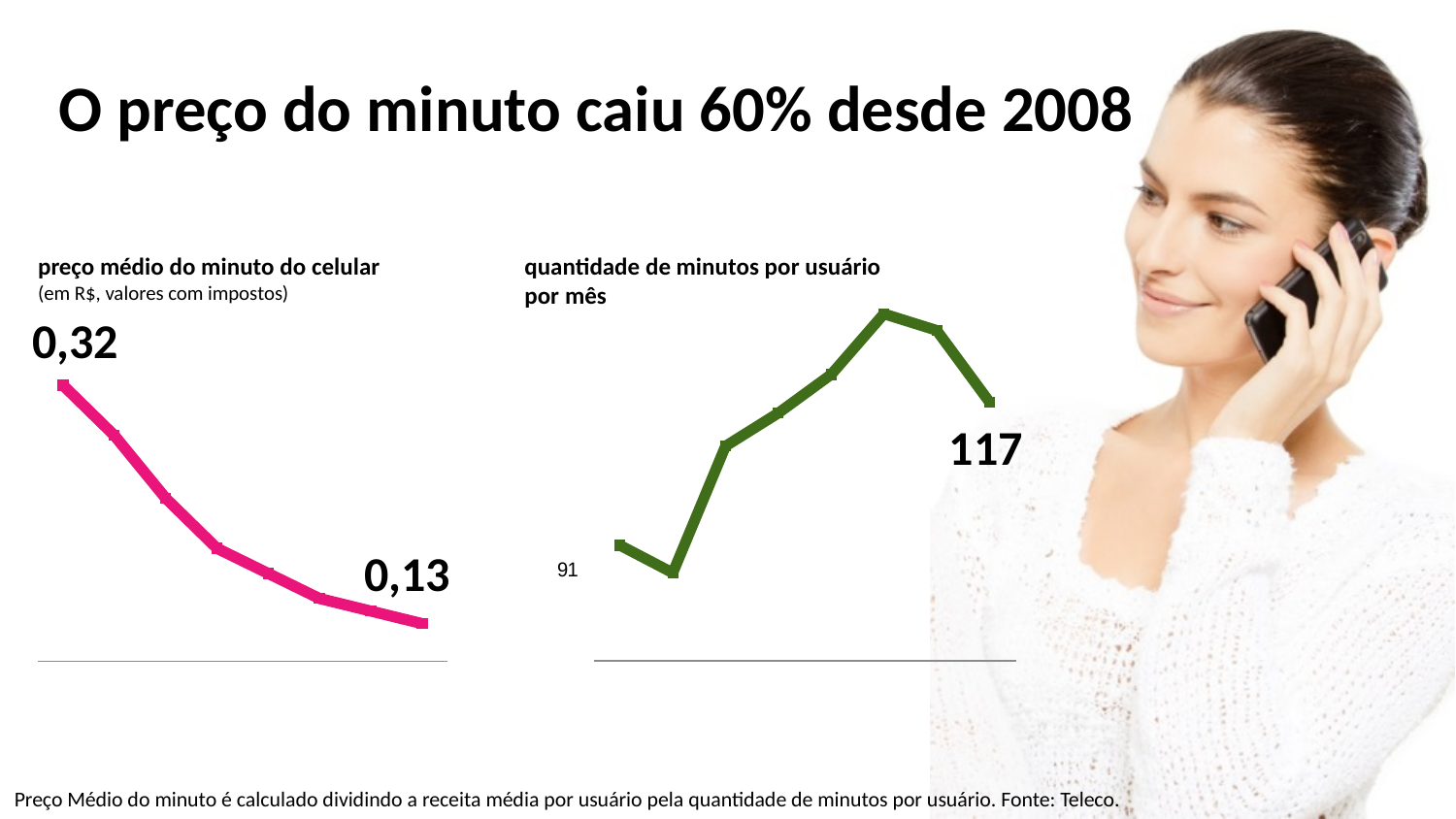
What kind of chart is the right chart, 'quantidade de minutos por usuário por mês'? line chart In the left chart 'preço médio do minuto do celular', is the first value (0,32) larger or smaller than the last value (0,13)? larger In the left chart 'preço médio do minuto do celular', do the values rise or fall along the x axis? fall In the right chart 'quantidade de minutos por usuário por mês', is the last value (117) larger or smaller than the first value (91)? larger In the left chart 'preço médio do minuto do celular', what is the value of the last point? 0,13 In the right chart 'quantidade de minutos por usuário por mês', what is the value of the first point? 91 In the left chart 'preço médio do minuto do celular', what is the value of the first point? 0,32 What kind of chart is the left chart, 'preço médio do minuto do celular'? line chart In the right chart 'quantidade de minutos por usuário por mês', what is the value of the last point? 117 In the left chart 'preço médio do minuto do celular', what is the difference between the first value (0,32) and the last value (0,13)? 0,19 What unit is stated under the title of the left chart 'preço médio do minuto do celular'? em R$, valores com impostos In the right chart 'quantidade de minutos por usuário por mês', what is the difference between the last value (117) and the first value (91)? 26